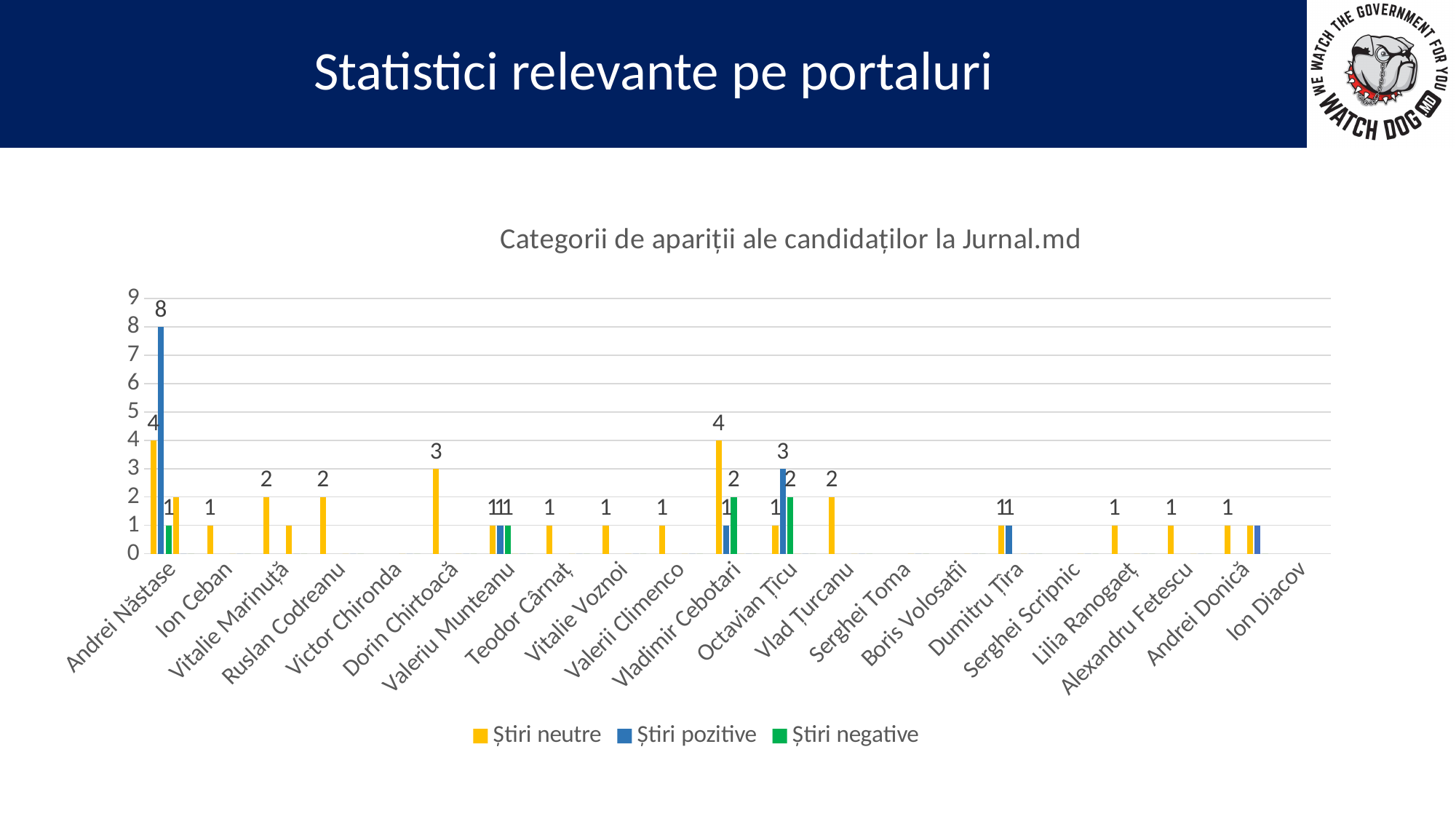
How many series does the legend list? 3 What is the value of Știri pozitive for Octavian Țîcu? 3 What is the title of the chart? Categorii de apariții ale candidaților la Jurnal.md What is the total of the three series for Vladimir Cebotari? 7 What is the value of Știri pozitive for Andrei Năstase? 8 What is the difference between Știri pozitive and Știri neutre for Andrei Năstase? 4 What is the value of Știri negative for Vladimir Cebotari? 2 What kind of chart is shown on the slide? bar chart Is the value of Știri pozitive for Andrei Năstase greater or less than 5? greater Which candidate has the highest value for Știri pozitive? Andrei Năstase What is the value of Știri neutre for Dorin Chirtoacă? 3 Which is larger: Știri neutre for Dorin Chirtoacă or Știri neutre for Vlad Țurcanu? Dorin Chirtoacă